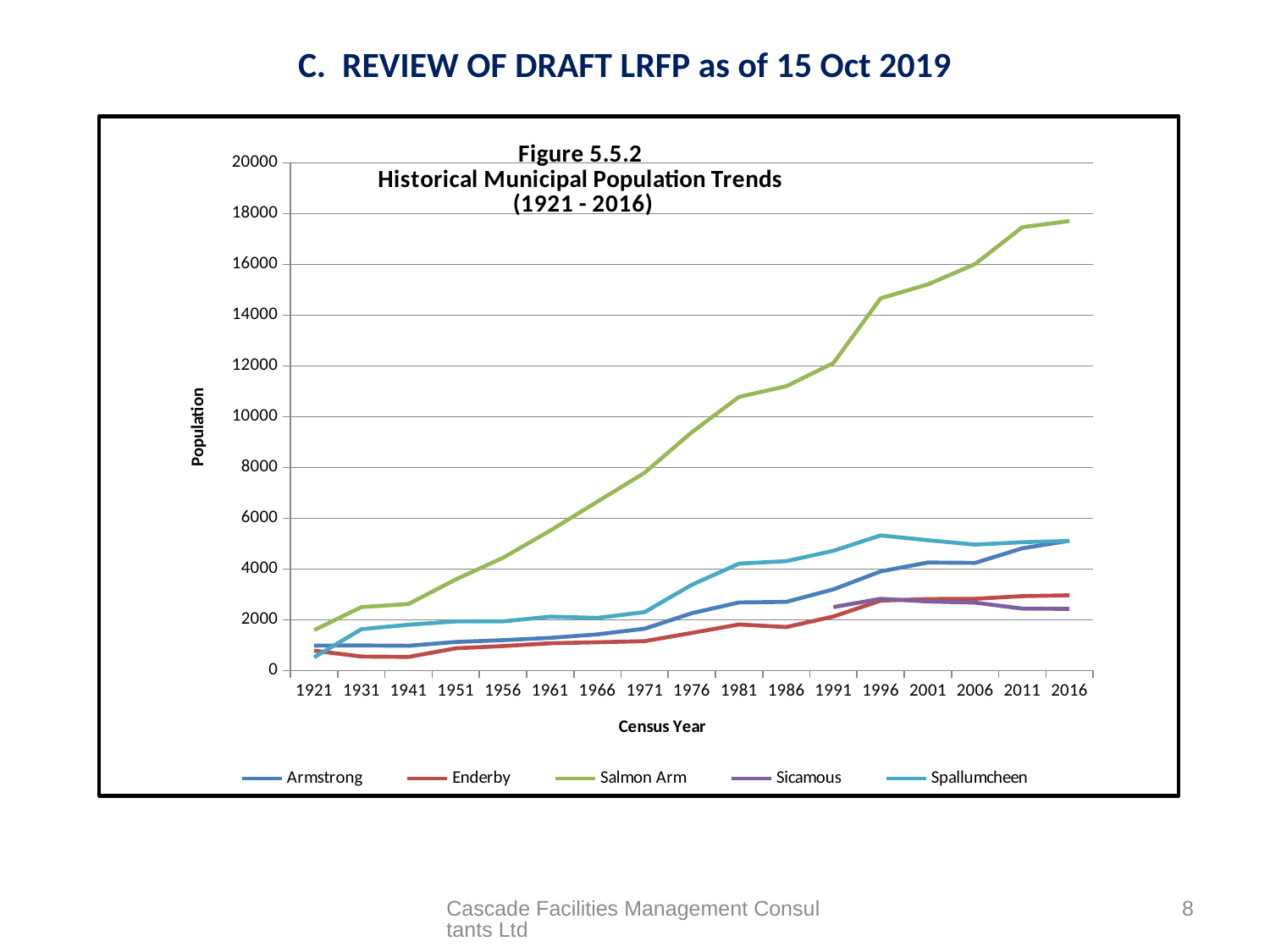
Does the population of Salmon Arm rise or fall from 1921 to 2016? Rise Is the population of Salmon Arm in 2016 greater or less than 16000? greater Is the population of Spallumcheen in 1921 greater or less than 2000? less Is the population of Enderby in 2016 greater or less than 4000? less What kind of chart is shown in Figure 5.5.2? Line chart What is the label on the y axis of the chart? Population Which municipality's line only begins at the 1991 census year? Sicamous How many municipalities are listed in the chart's legend? 5 How many census years are shown along the x axis? 17 Which has the larger population in 2016, Armstrong or Enderby? Armstrong Which municipality has the lowest population in 2016? Sicamous Which municipality has the highest population in 2016? Salmon Arm